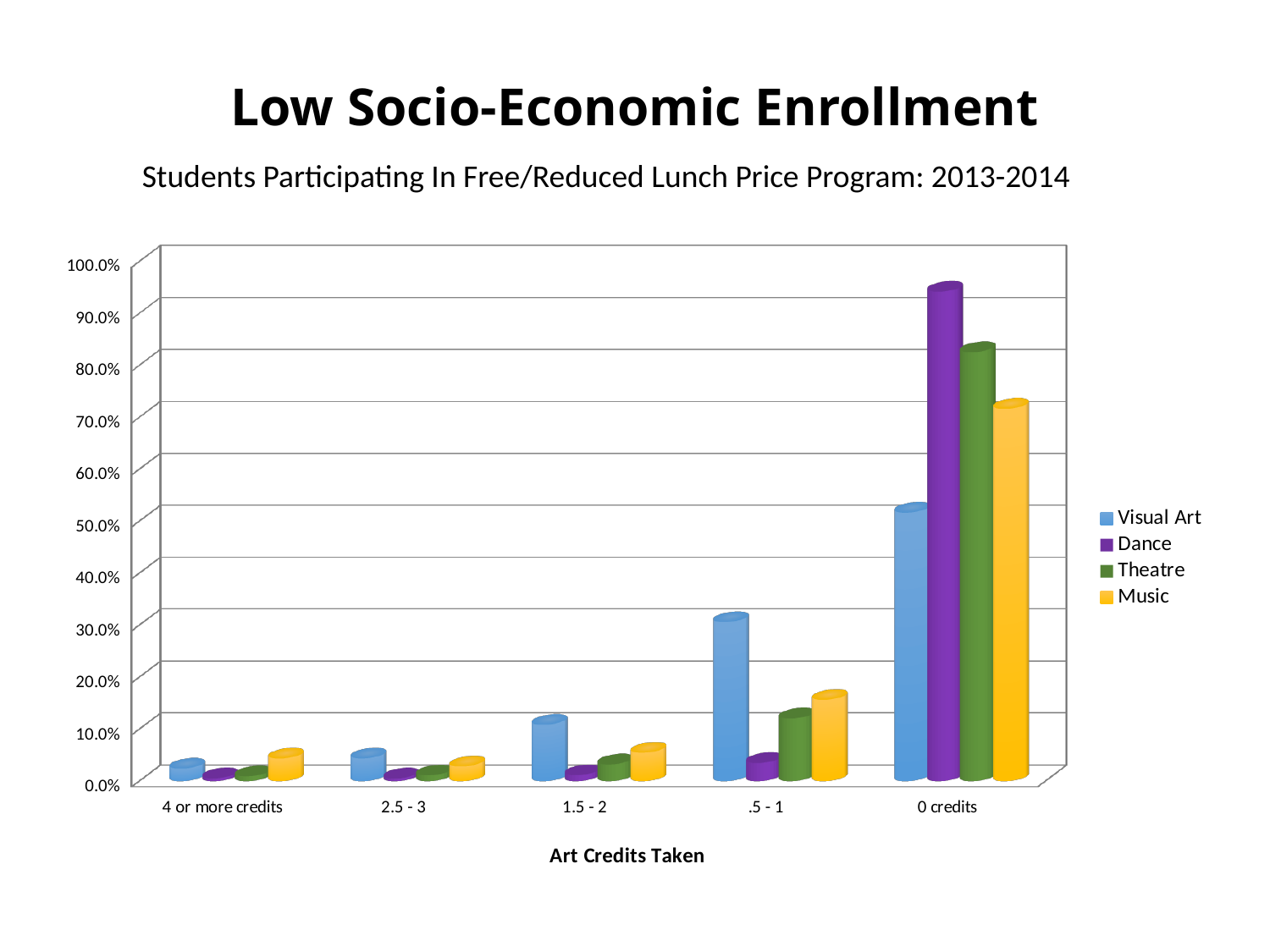
Which series has the highest value in the 0 credits category? Dance What kind of chart is shown on the slide? bar chart How many categories are shown on the x axis? 5 Is the value for Theatre in the 0 credits category greater or less than 70.0%? greater Which series has the lowest value in the .5 - 1 category? Dance How many series does the legend list? 4 Do the Visual Art values rise or fall moving from left to right along the x axis? rise In the 0 credits category, which is larger, the value for Theatre or the value for Visual Art? Theatre Is the value for Dance in the 0 credits category greater or less than 90.0%? greater Is the value for Music in the 0 credits category greater or less than 80.0%? less What is the title of the x axis? Art Credits Taken